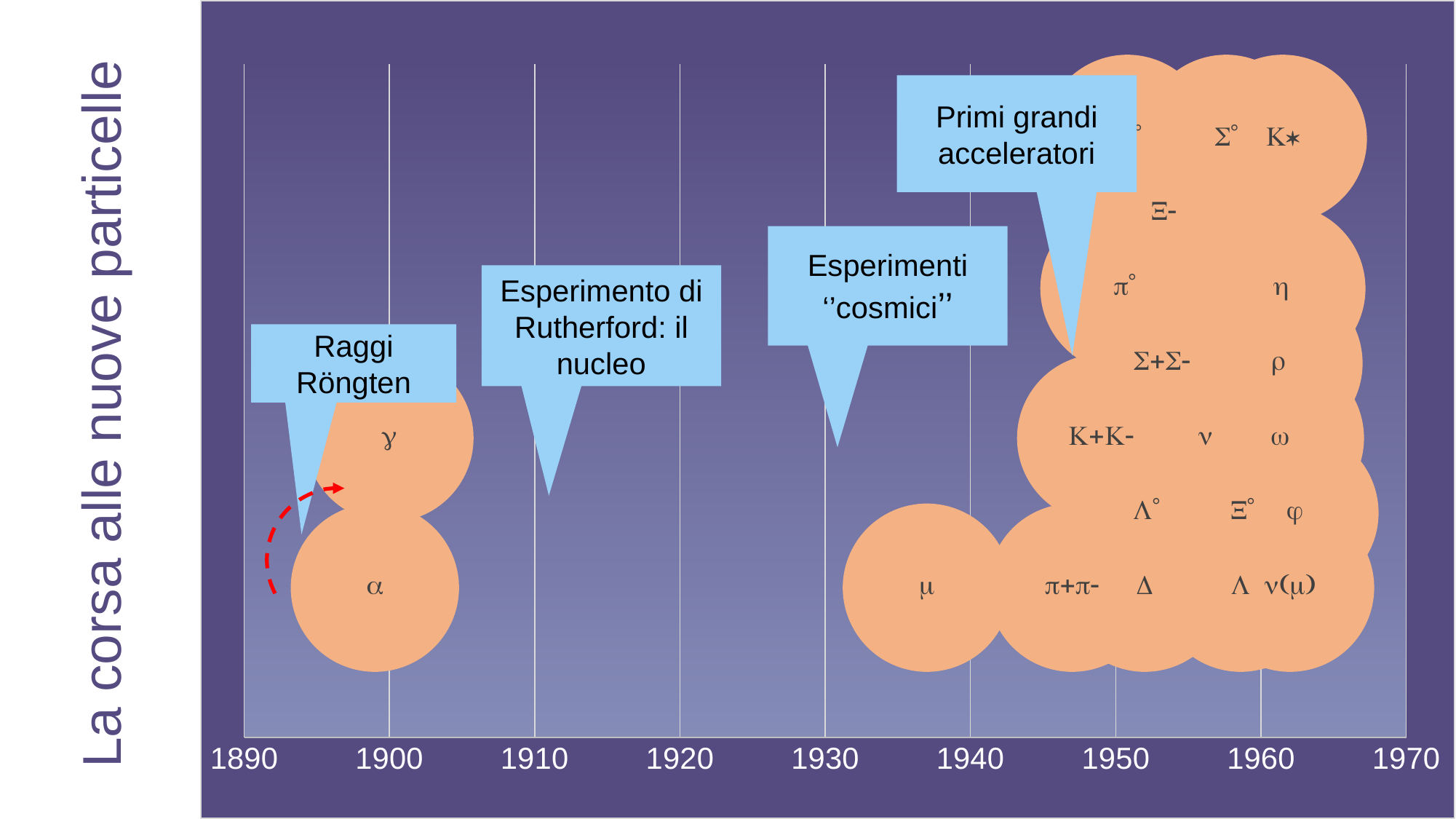
Does the number of particles shown increase or decrease as the years advance along the axis? increase What does the callout pointing to the 1930s say? Esperimenti ''cosmici'' How many year labels are shown along the horizontal axis? 9 What is the earliest year labelled on the horizontal axis of the timeline? 1890 Which particle is placed earliest on the timeline? α What kind of diagram is shown on the slide? timeline Is the μ particle placed before or after 1930 on the timeline? after What is the title of the slide? La corsa alle nuove particelle Which particle appears earlier on the timeline, α or μ? α What is the spacing between consecutive year labels on the horizontal axis? 10 years What is the latest year labelled on the horizontal axis of the timeline? 1970